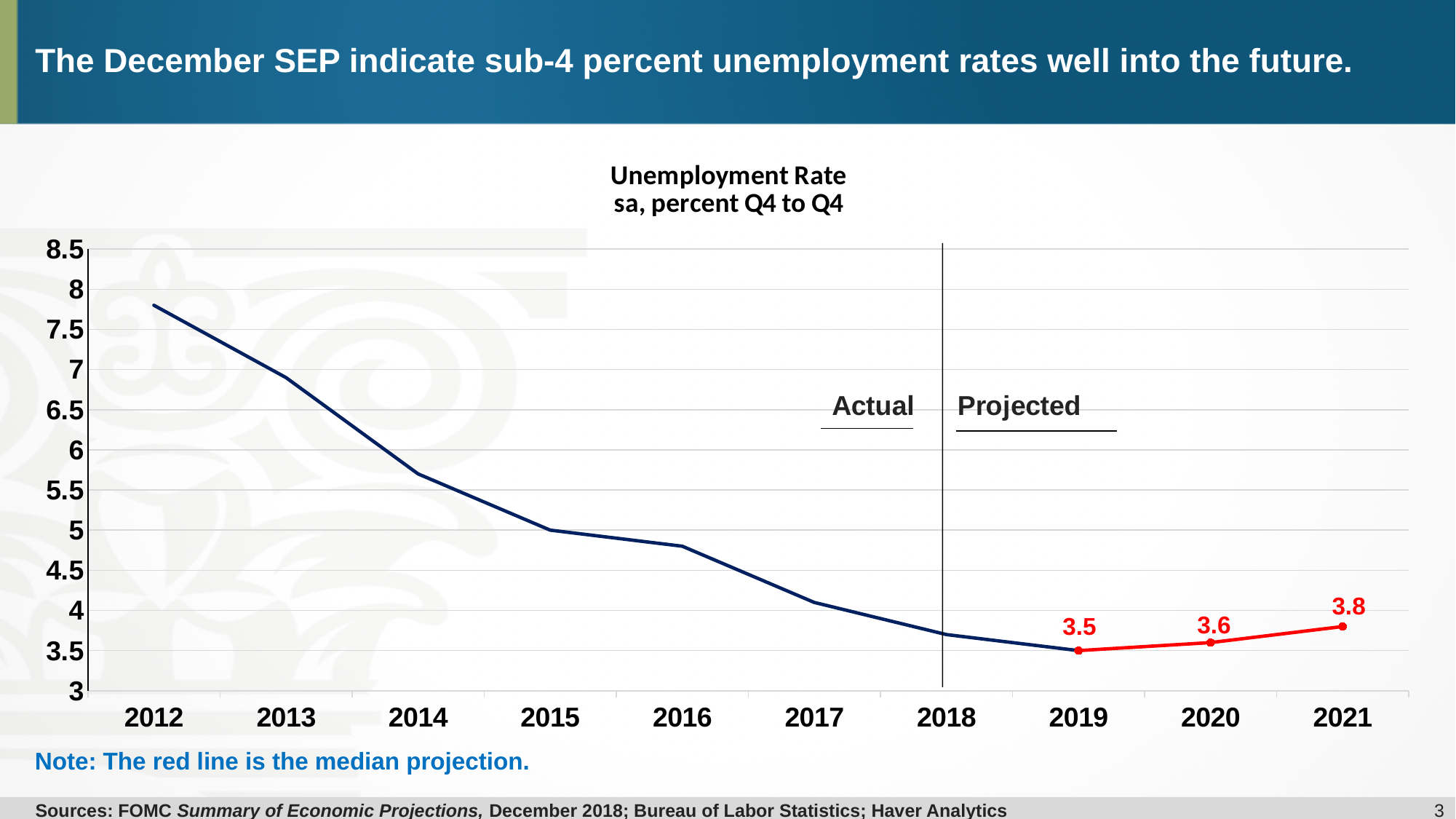
How many years are shown on the x axis of the chart? 10 By how much does the projected unemployment rate rise from 2019 to 2021? 0.3 What kind of chart is shown on the slide? line chart Does the unemployment rate rise or fall from 2012 to 2019? fall Is the unemployment rate for 2017 greater or less than 4.5? less Which year has the highest unemployment rate on the chart? 2012 Is the unemployment rate for 2014 greater or less than 5.5? greater What is the projected unemployment rate for 2019? 3.5 Is the unemployment rate for 2012 greater or less than 7? greater Which year has the lowest unemployment rate on the chart? 2019 What is the projected unemployment rate for 2020? 3.6 What is the projected unemployment rate for 2021? 3.8